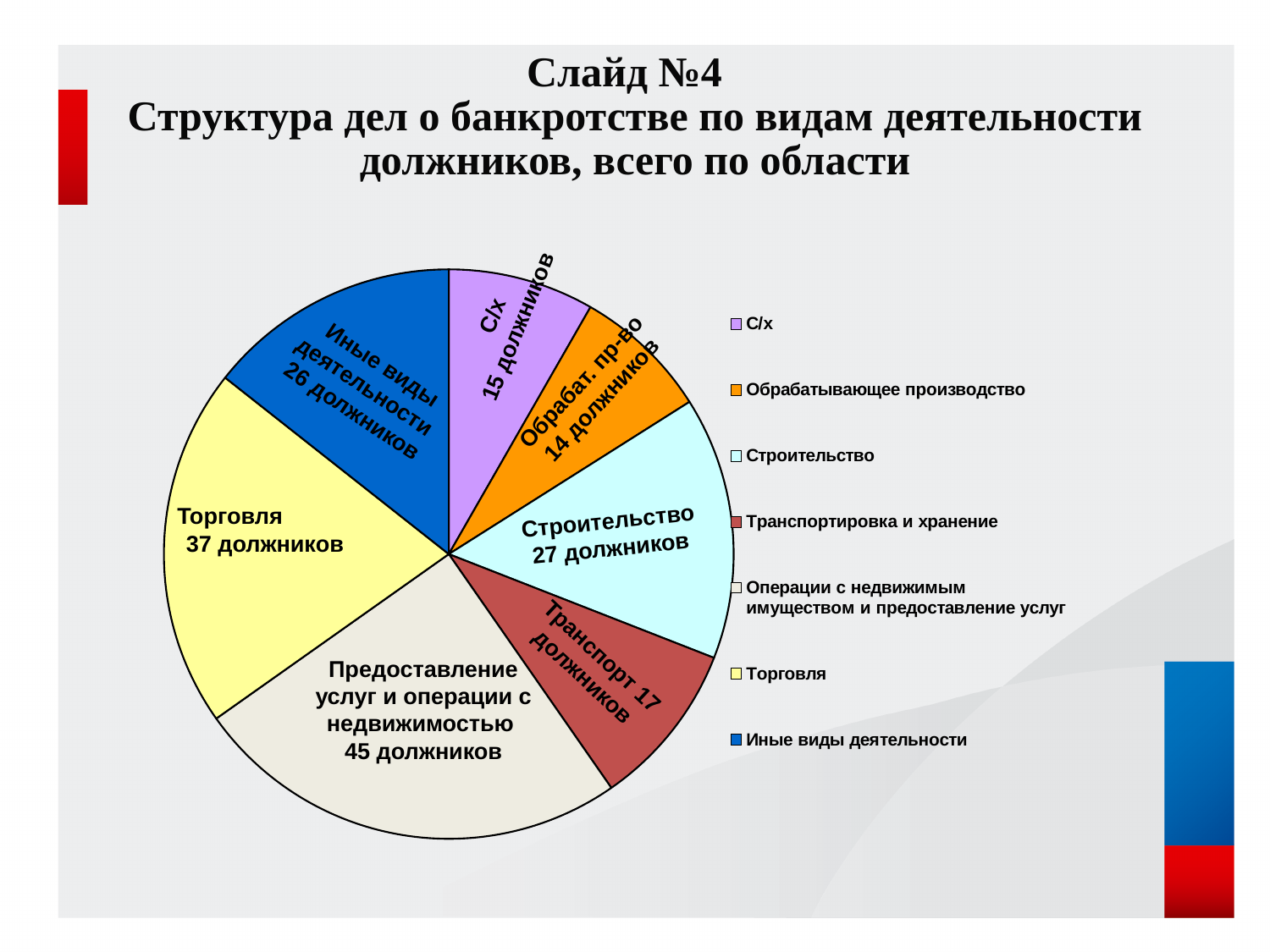
What colour is the Торговля slice in the pie chart? Yellow How many debtors does the С/х slice show? 15 должников Which category has the largest slice of the pie? Предоставление услуг и операции с недвижимостью (45 должников) What is the difference in debtors between Торговля and Иные виды деятельности? 11 How many slices does the pie chart have? 7 What is the value labelled on the Строительство slice? 27 должников What type of chart is shown on the slide? Pie chart What is the difference in debtors between Строительство and Транспорт? 10 What is the total number of debtors across all slices of the pie? 181 Which has more debtors, Строительство or Иные виды деятельности? Строительство How many debtors are shown for the Торговля slice? 37 должников Which category has the smallest slice of the pie? Обрабат. пр-во (14 должников)